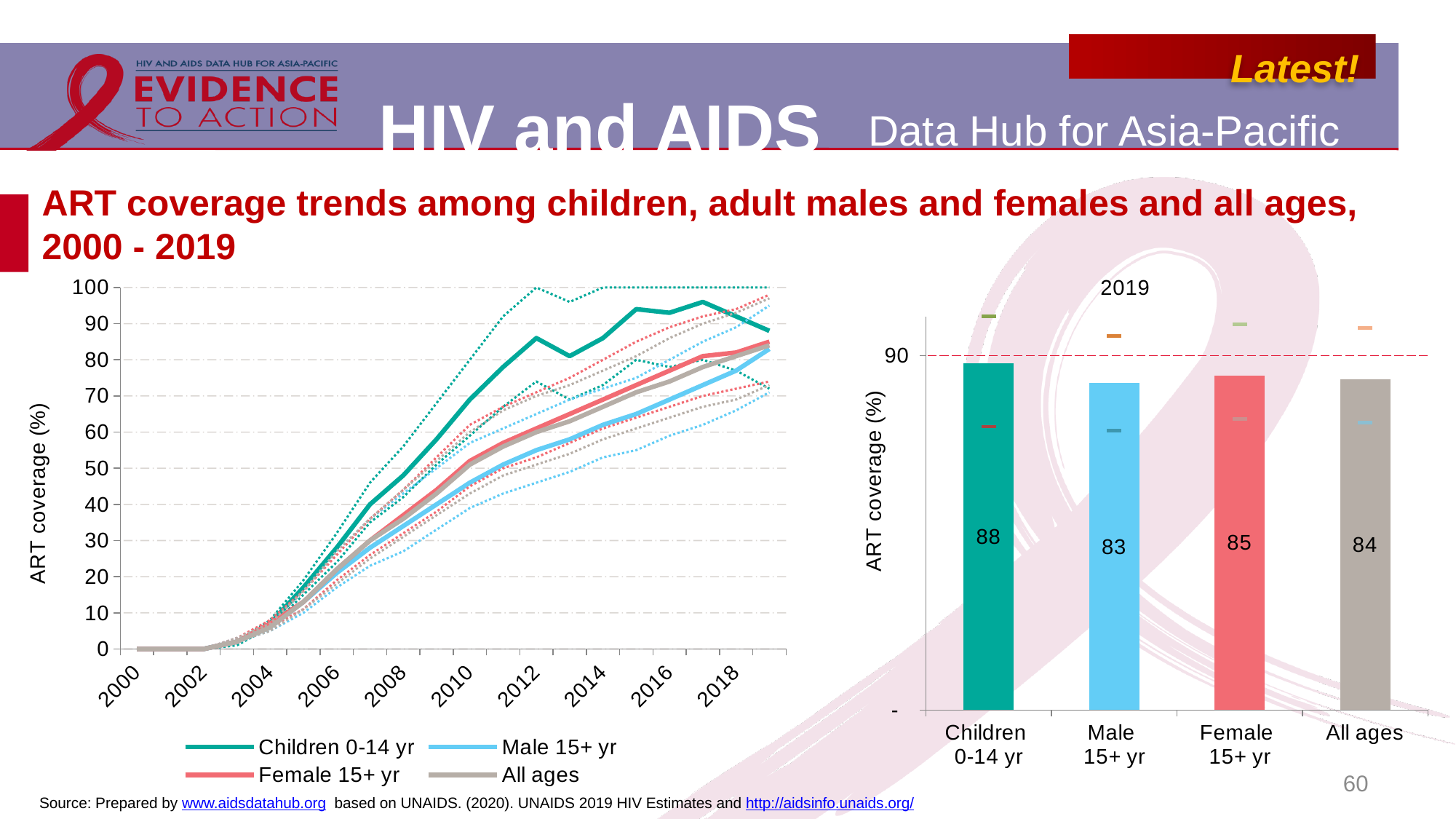
In the 2019 bar chart on the right, what is the ART coverage value for Male 15+ yr? 83 In the 2019 bar chart on the right, what is the difference between the ART coverage for Children 0-14 yr and Male 15+ yr? 5 What kind of chart is the chart on the left of the slide? Line chart What kind of chart is the chart on the right of the slide? Bar chart In the 2019 bar chart on the right, which category has the lowest ART coverage? Male 15+ yr In the line chart on the left, does the ART coverage for All ages generally rise or fall from 2000 to 2019? Rise In the 2019 bar chart on the right, how many categories are shown? 4 In the 2019 bar chart on the right, which category has the highest ART coverage? Children 0-14 yr In the line chart on the left, how many series does the legend list? 4 In the 2019 bar chart on the right, what is the ART coverage value for Children 0-14 yr? 88 In the 2019 bar chart on the right, which is larger: the value for Female 15+ yr or the value for All ages? Female 15+ yr In the 2019 bar chart on the right, what is the ART coverage value for All ages? 84